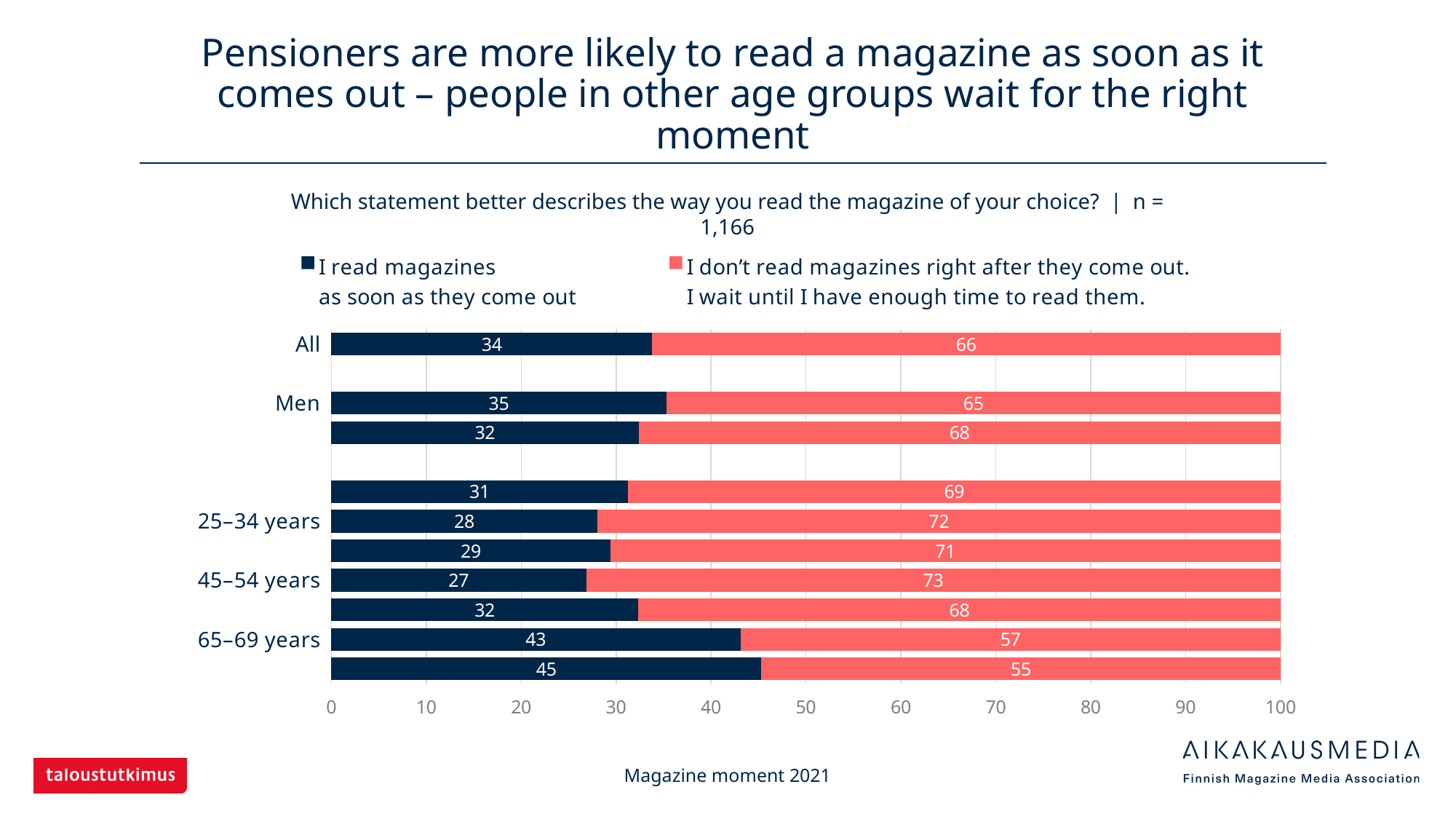
What is the value for 65–69 years for 'I read magazines as soon as they come out'? 43 How many series does the legend list? 2 Which has a larger value for 'I read magazines as soon as they come out': Men or 45–54 years? Men What colour represents 'I read magazines as soon as they come out' in the chart? Dark navy blue What kind of chart is shown on the slide? Stacked bar chart What is the value for 45–54 years for 'I don't read magazines right after they come out'? 73 What is the total of the stacked bar for All? 100 What is the value for Men for 'I don't read magazines right after they come out'? 65 How many bars (rows) are plotted in the chart? 10 What is the difference between the 65–69 years and 25–34 years values for 'I read magazines as soon as they come out'? 15 What percentage of All respondents say they read magazines as soon as they come out? 34 What is the value for 25–34 years for 'I read magazines as soon as they come out'? 28